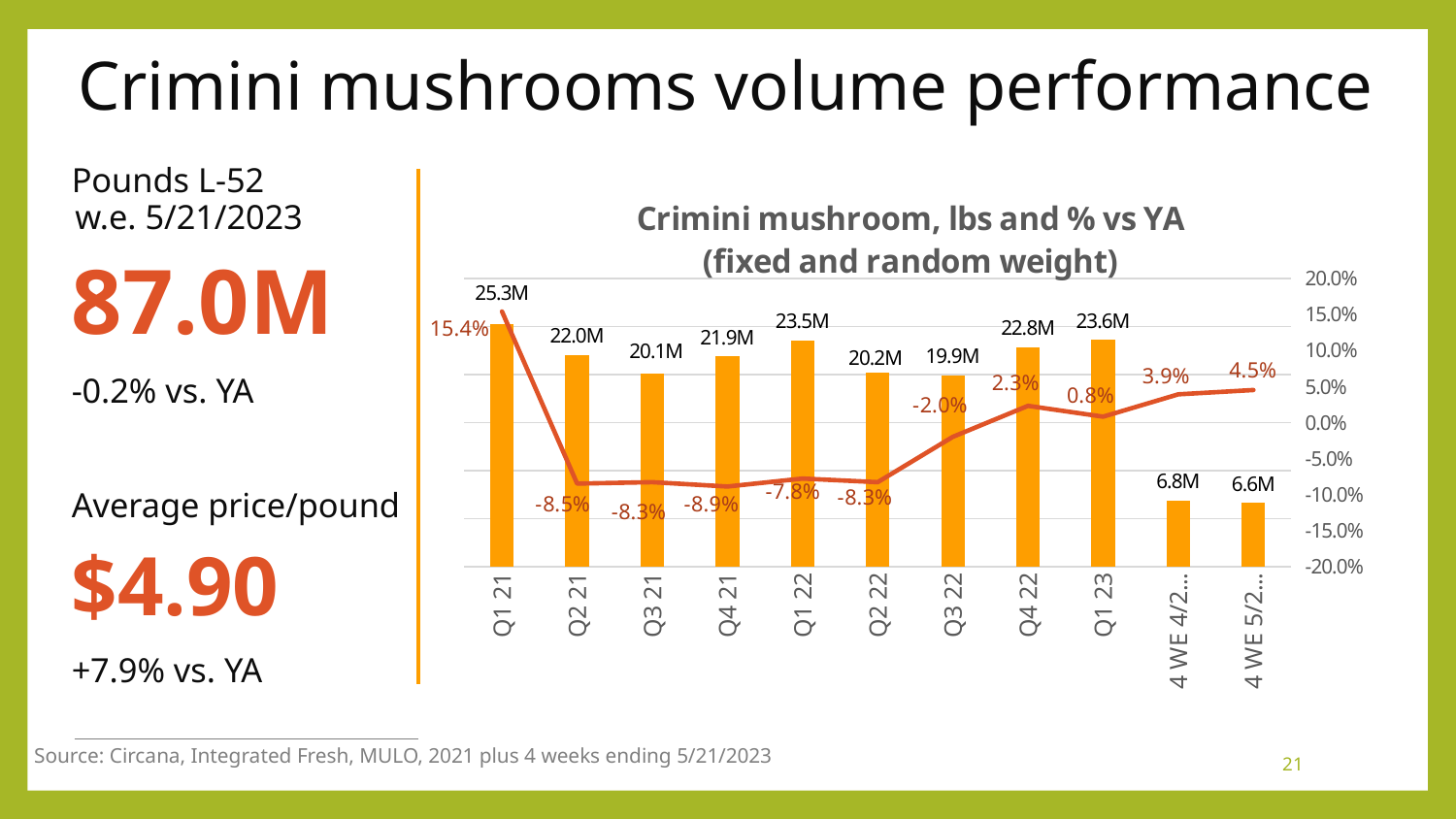
Which quarter has the highest volume in pounds? Q1 21 Among the quarterly bars (Q1 21 through Q1 23), which quarter has the lowest volume in pounds? Q3 22 What is the title of the chart? Crimini mushroom, lbs and % vs YA (fixed and random weight) Is the % vs YA value for Q1 21 greater or less than 10.0%? greater Which is larger, the volume for Q2 21 or the volume for Q4 21? Q2 21 How many periods are shown on the x axis? 11 What is the % vs YA value for Q3 22? -2.0% What is the difference in pounds between Q1 22 and Q2 22? 3.3M What is the volume in pounds for Q4 22? 22.8M What is the % vs YA value for Q1 23? 0.8% What is the volume in pounds for Q1 21? 25.3M Which period has the lowest % vs YA value? Q4 21